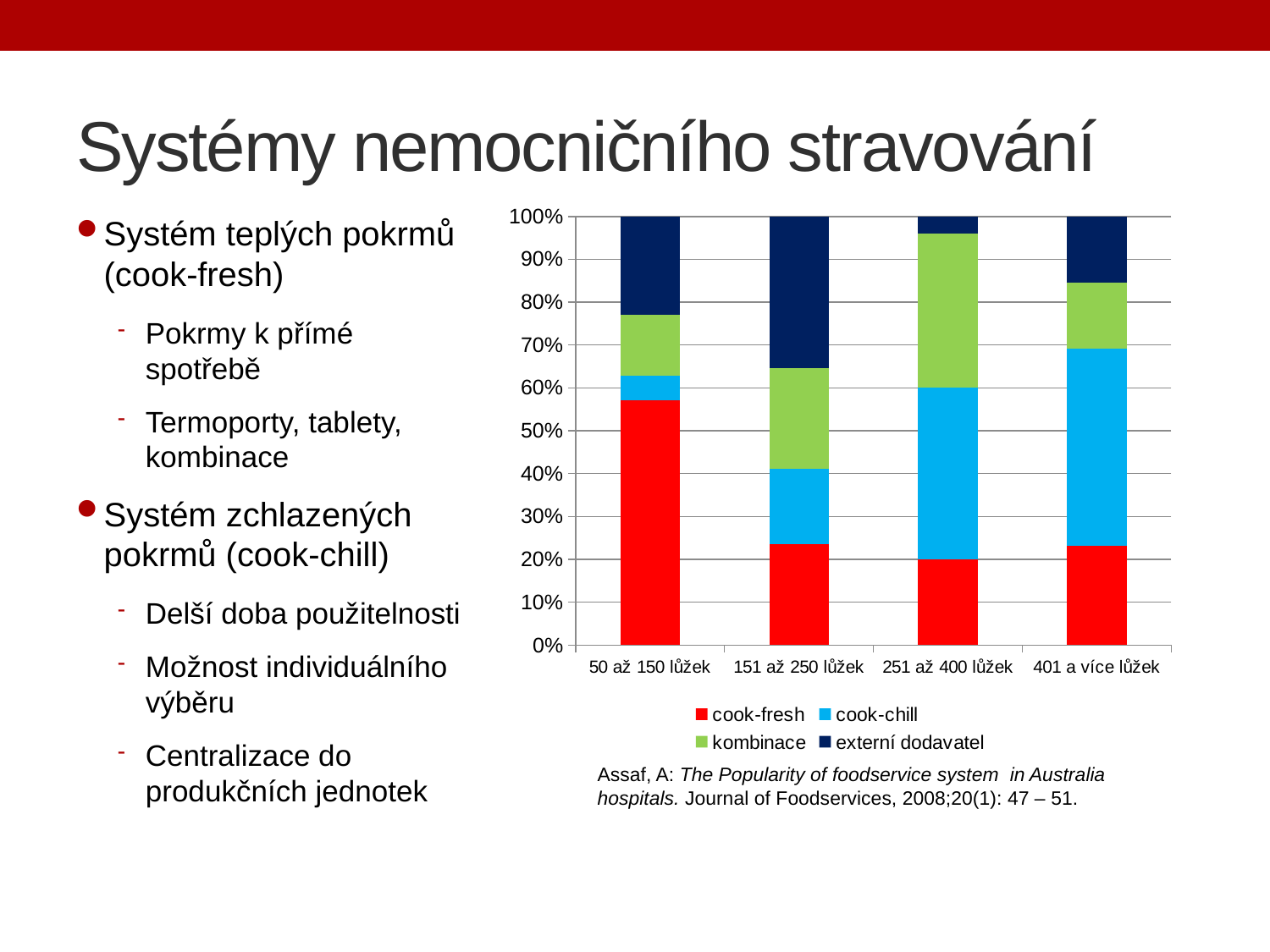
Which colour represents the cook-fresh series in the chart? Red Which category has the larger cook-chill share: 50 až 150 lůžek or 401 a více lůžek? 401 a více lůžek How many series does the chart legend list? 4 Which category has the largest externí dodavatel share? 151 až 250 lůžek How many hospital size categories are shown on the x axis of the chart? 4 Is the cook-fresh share for 251 až 400 lůžek greater or less than 30%? less Which category has the largest kombinace share? 251 až 400 lůžek What kind of chart is shown on the slide? Stacked bar chart What is the total height of the stacked bar for 50 až 150 lůžek? 100% Which category has the largest cook-fresh share in the chart? 50 až 150 lůžek Is the cook-fresh share for 50 až 150 lůžek greater or less than 50%? greater Which category has the smallest externí dodavatel share? 251 až 400 lůžek